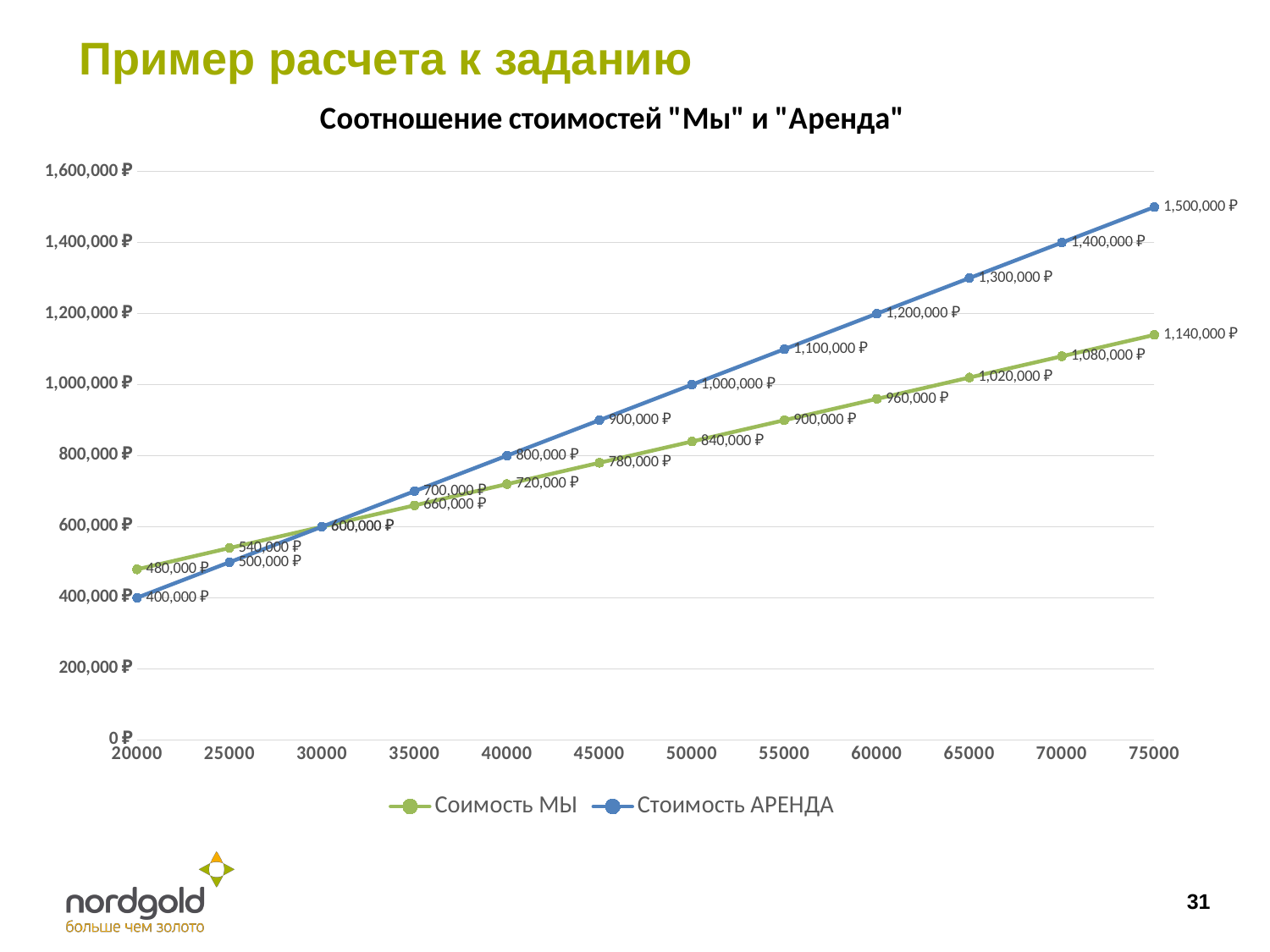
What is the value of "Соимость МЫ" at 75000? 1,140,000 ₽ How many series does the legend list? 2 How many data points are plotted for the "Стоимость АРЕНДА" series? 12 At 20000, which series has the larger value, "Соимость МЫ" or "Стоимость АРЕНДА"? Соимость МЫ What is the title of the chart? Соотношение стоимостей "Мы" и "Аренда" What type of chart is shown on the slide? Line chart What is the value of "Стоимость АРЕНДА" at 75000? 1,500,000 ₽ What is the value of "Стоимость АРЕНДА" at 20000? 400,000 ₽ What is the difference between "Стоимость АРЕНДА" and "Соимость МЫ" at 75000? 360,000 ₽ At 60000, which series has the larger value, "Соимость МЫ" or "Стоимость АРЕНДА"? Стоимость АРЕНДА What is the value of "Соимость МЫ" at 20000? 480,000 ₽ Do the values of "Соимость МЫ" rise or fall as the x-axis value increases? Rise